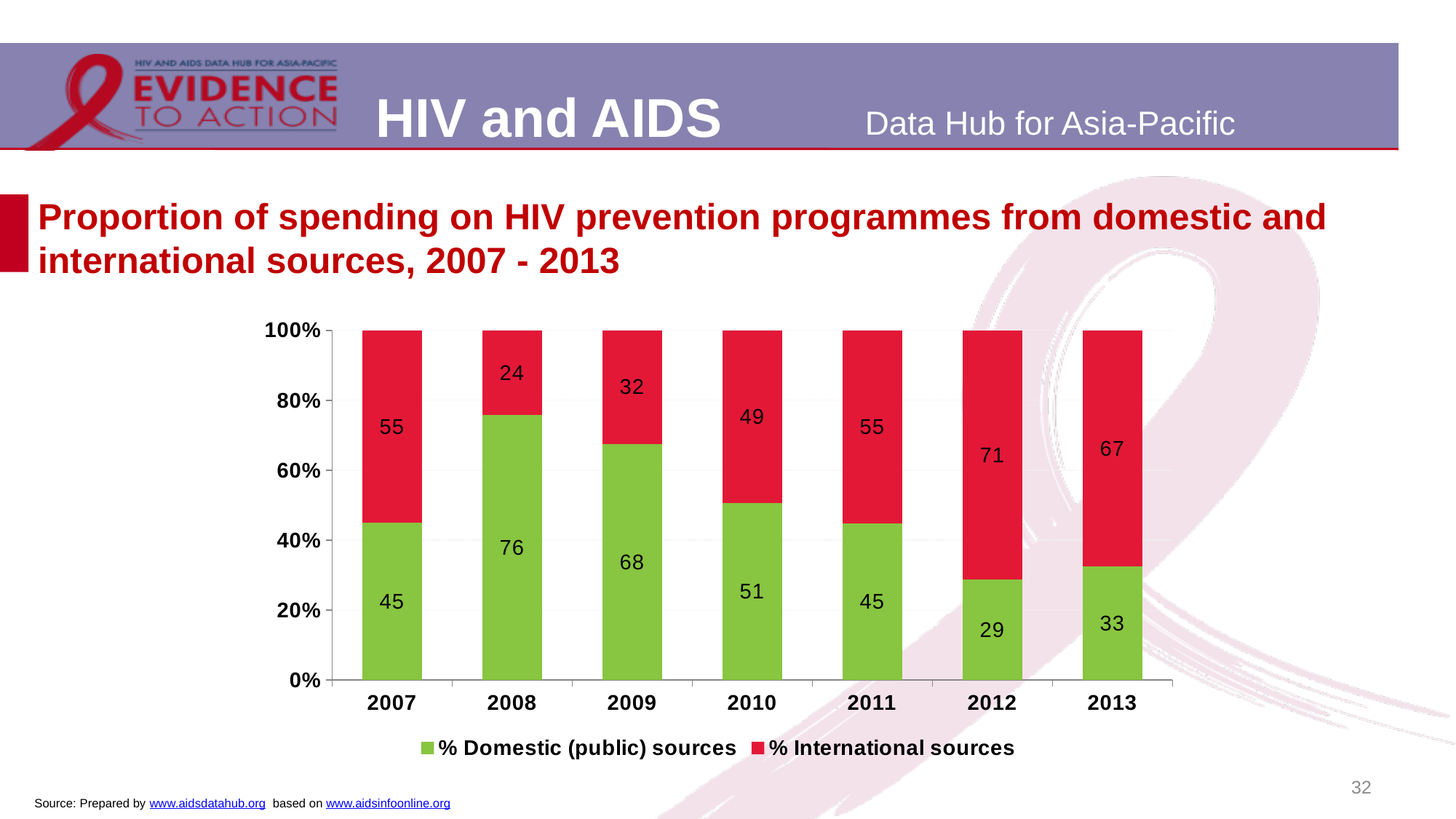
In which year is the % International sources value lowest? 2008 In which year is the % Domestic (public) sources value lowest? 2012 What is the value for % Domestic (public) sources in 2013? 33 In which year is the % Domestic (public) sources value highest? 2008 Which is larger in 2010: % Domestic (public) sources or % International sources? % Domestic (public) sources What is the difference between the % International sources values for 2012 and 2008? 47 What kind of chart is shown on the slide? Stacked bar chart What is the value for % Domestic (public) sources in 2008? 76 What is the value for % International sources in 2012? 71 How many series does the legend list? 2 How many years are shown on the x axis? 7 Which colour represents % International sources in the chart? Red